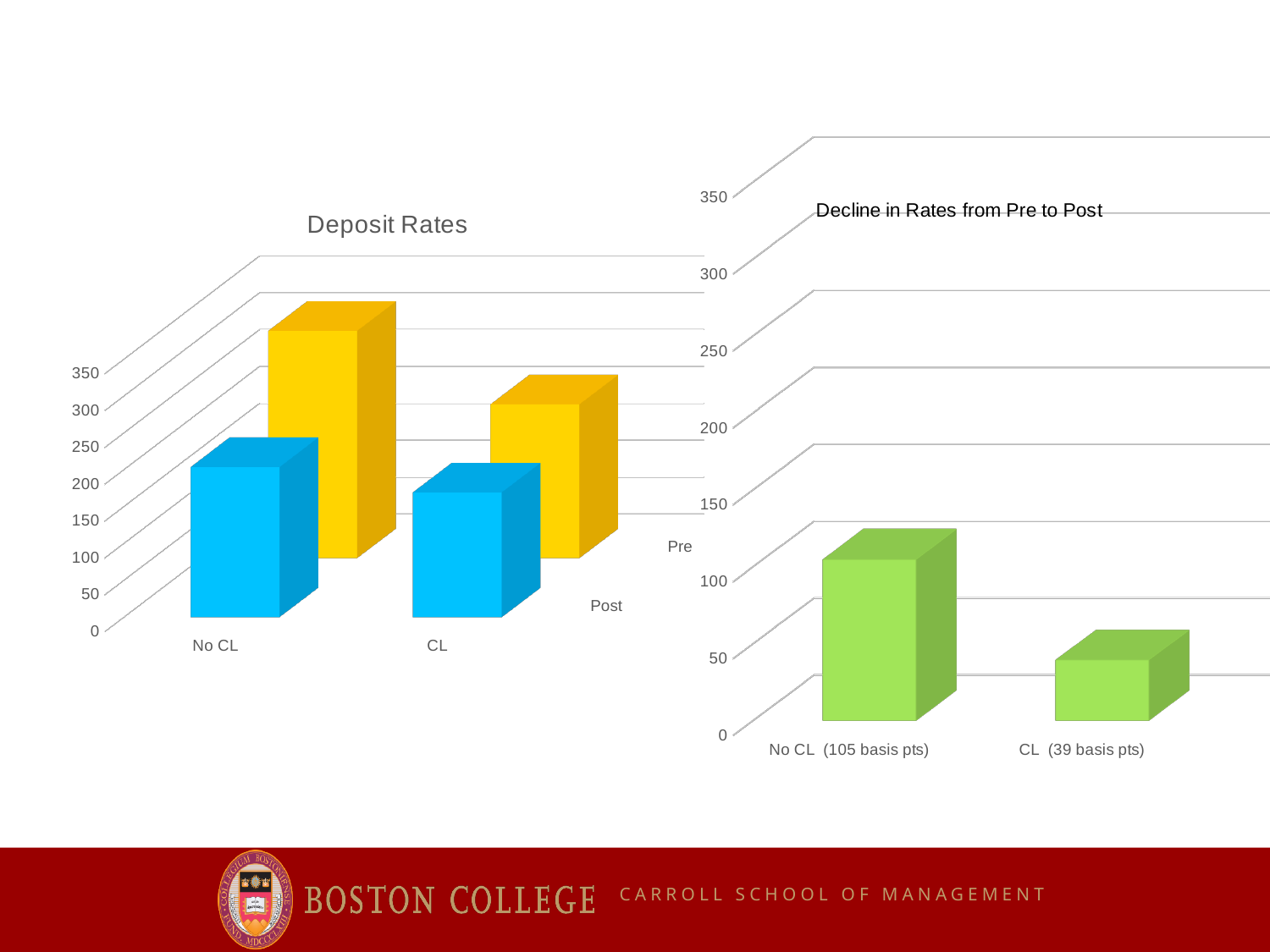
What kind of chart is the 'Decline in Rates from Pre to Post' chart? Bar chart In the 'Deposit Rates' chart, for No CL, is the Pre rate or the Post rate higher? Pre In the 'Decline in Rates from Pre to Post' chart, what is the decline for CL? 39 basis pts In the 'Deposit Rates' chart, for CL, is the Pre rate or the Post rate higher? Pre In the 'Deposit Rates' chart, how many series are plotted? 2 In the 'Decline in Rates from Pre to Post' chart, how many categories are shown? 2 In the 'Decline in Rates from Pre to Post' chart, which category has the smaller decline? CL In the 'Decline in Rates from Pre to Post' chart, what is the difference in basis points between the No CL and CL declines? 66 basis pts In the 'Deposit Rates' chart, is the Pre rate higher for No CL or for CL? No CL In the 'Decline in Rates from Pre to Post' chart, what is the decline for No CL? 105 basis pts What is the title of the chart on the left of the slide? Deposit Rates In the 'Decline in Rates from Pre to Post' chart, which category has the larger decline? No CL